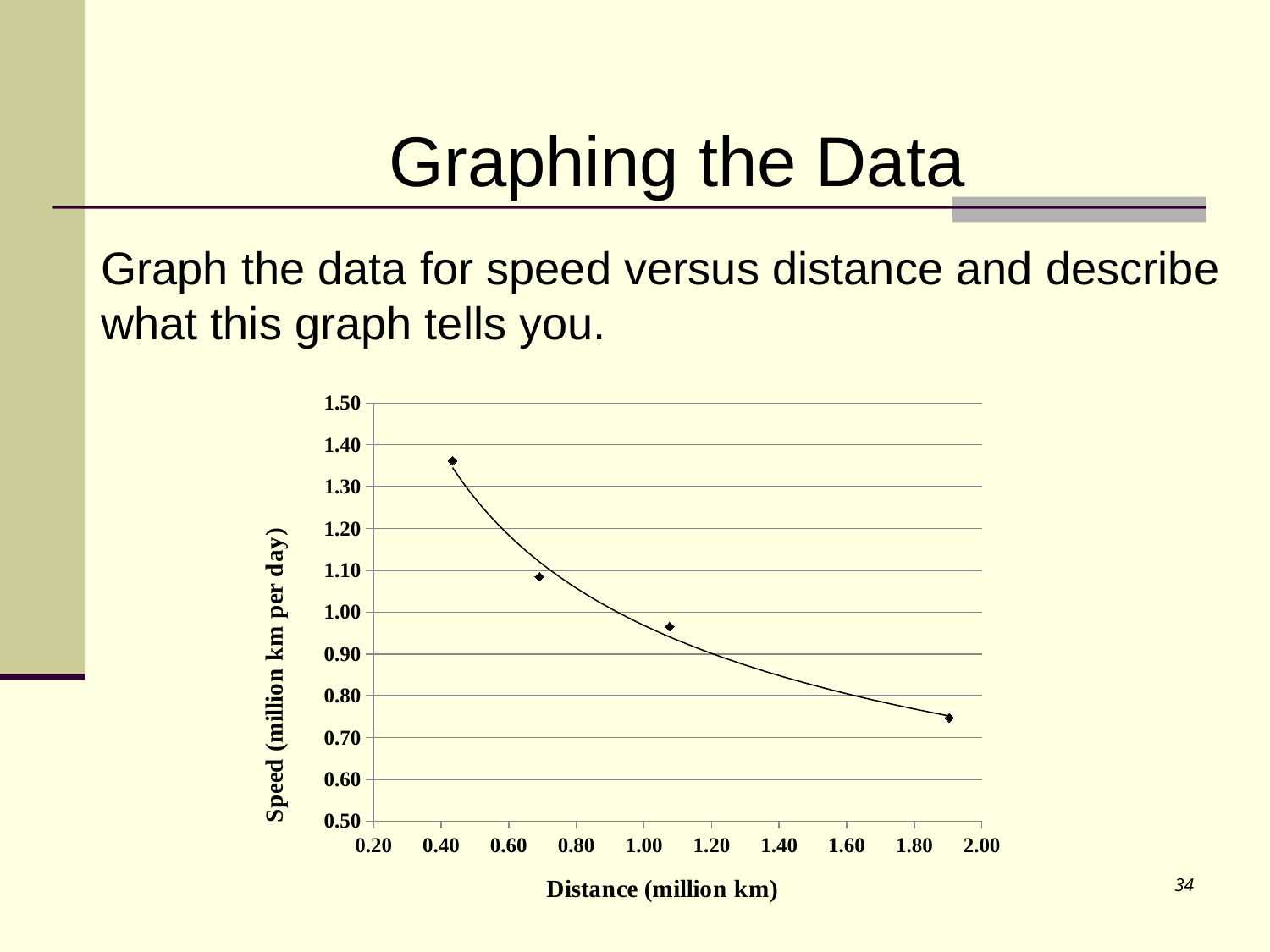
How many data points are plotted on the chart? 4 Which data point has the highest speed value, the leftmost or the rightmost? leftmost Is the speed value for the leftmost data point greater or less than 1.30? greater Is the speed value for the third data point from the left greater or less than 0.90? greater Is the speed value for the second data point from the left greater or less than 1.00? greater What kind of chart is shown on the slide? scatter chart What is the title of the y axis? Speed (million km per day) Do the plotted speed values rise or fall as distance increases along the x axis? fall What is the title of the x axis? Distance (million km)